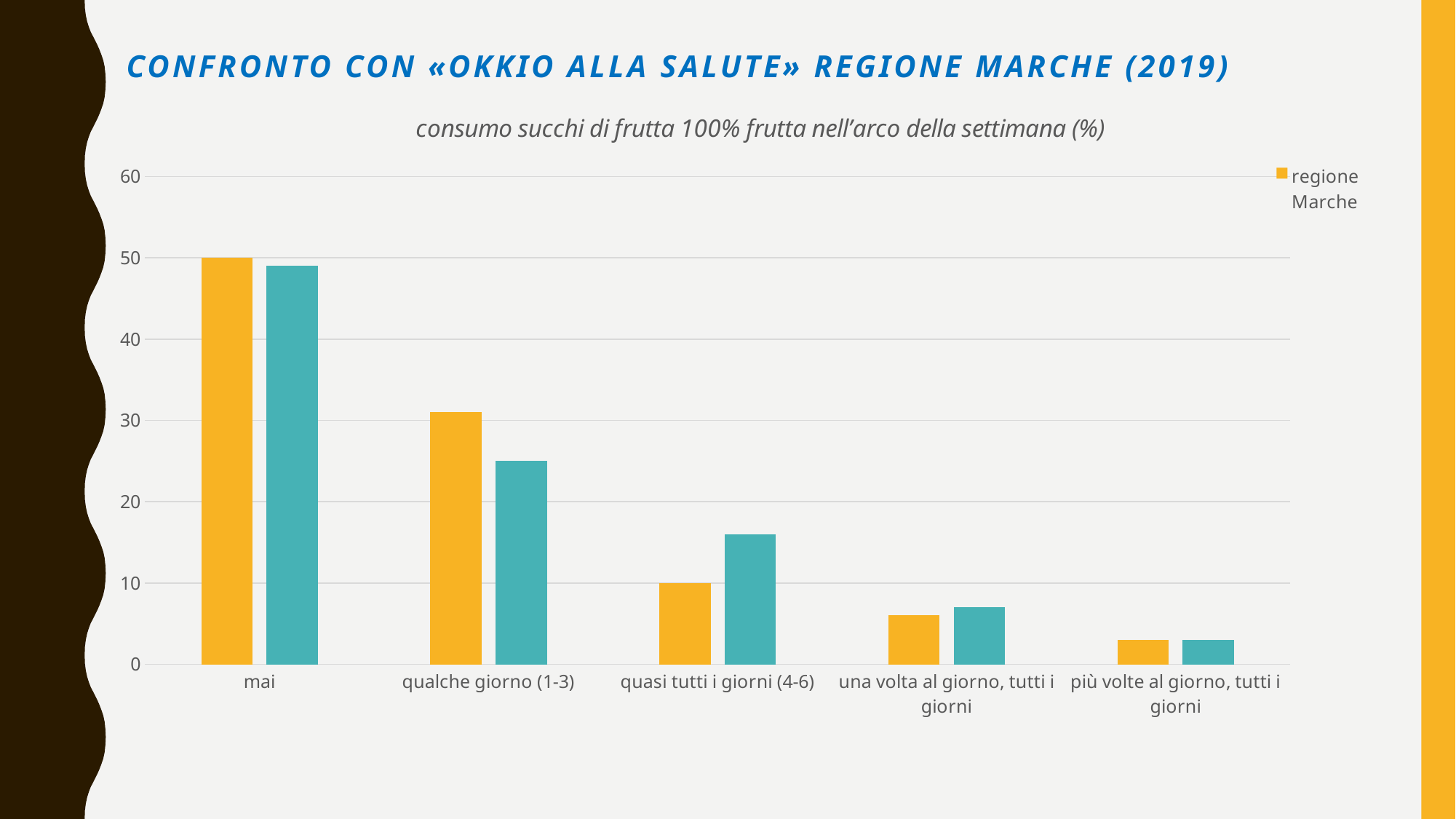
For 'qualche giorno (1-3)', which bar is larger: the yellow 'regione Marche' bar or the teal bar? the yellow 'regione Marche' bar Which category has the lowest value for the 'regione Marche' series? più volte al giorno, tutti i giorni How many categories are shown on the x axis of the chart? 5 What kind of chart is shown on the slide? bar chart For 'quasi tutti i giorni (4-6)', which bar is larger: the yellow 'regione Marche' bar or the teal bar? the teal bar What is the value of the 'regione Marche' bar for 'mai'? 50 What is the value of the 'regione Marche' bar for 'quasi tutti i giorni (4-6)'? 10 Do the 'regione Marche' values rise or fall moving from left to right along the x axis? fall Is the teal bar for 'qualche giorno (1-3)' greater or less than 30? less Which category has the highest value for the 'regione Marche' series? mai Is the 'regione Marche' value for 'qualche giorno (1-3)' greater or less than 30? greater Is the teal bar for 'quasi tutti i giorni (4-6)' greater or less than 20? less